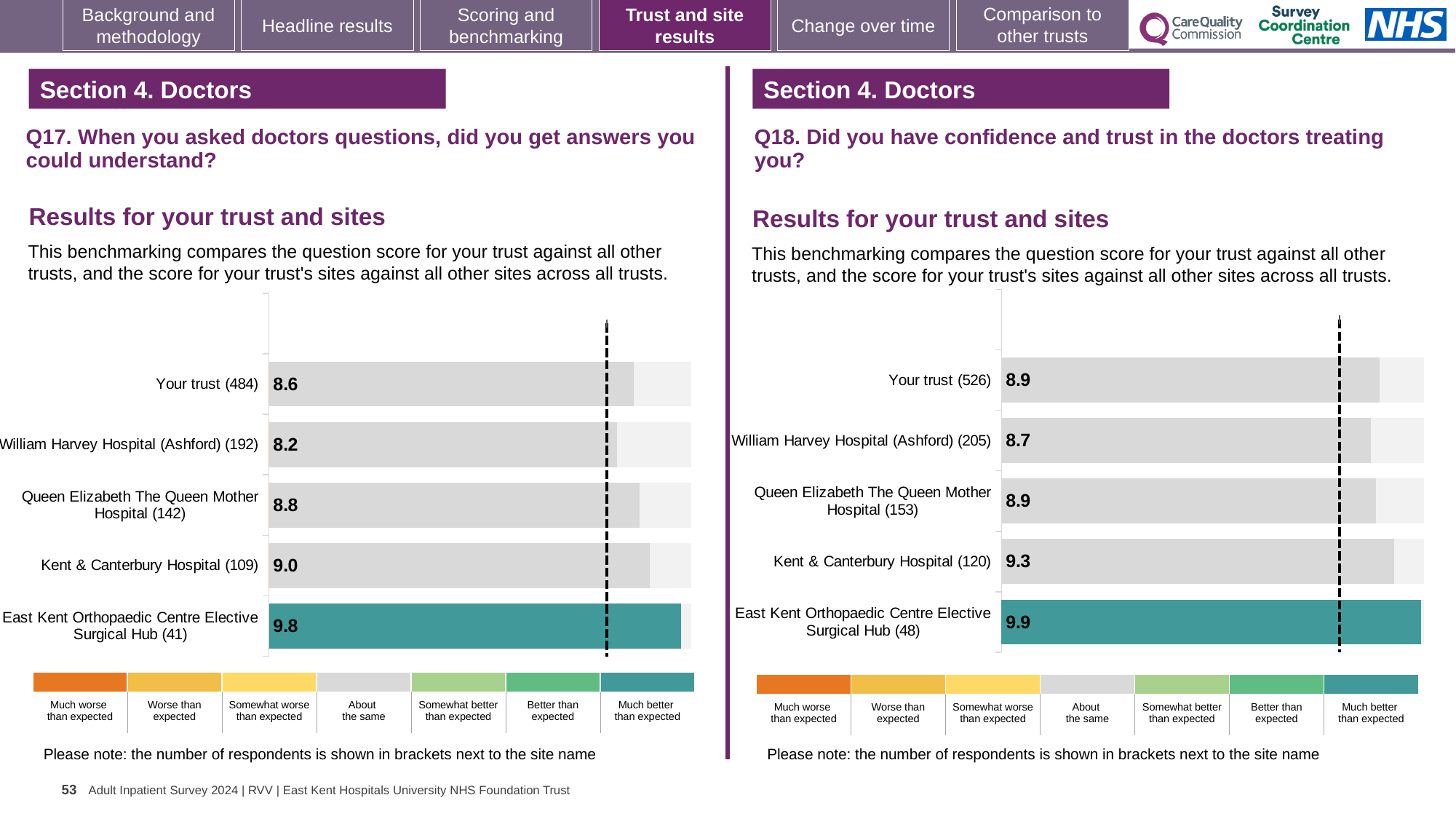
On the Q18 chart (right), what is the score for Kent & Canterbury Hospital (120)? 9.3 On the Q18 chart (right), which site has the highest score? East Kent Orthopaedic Centre Elective Surgical Hub (48) What type of chart is used on the Q18 chart (right)? Bar chart On the Q18 chart (right), what is the difference between the scores for East Kent Orthopaedic Centre Elective Surgical Hub (48) and Your trust (526)? 1.0 On the Q17 chart (left), what is the score for Your trust (484)? 8.6 On the Q17 chart (left), what is the difference between the scores for East Kent Orthopaedic Centre Elective Surgical Hub (41) and William Harvey Hospital (Ashford) (192)? 1.6 On the Q17 chart (left), which site has the highest score? East Kent Orthopaedic Centre Elective Surgical Hub (41) On the Q17 chart (left), what is the score for Kent & Canterbury Hospital (109)? 9.0 On the Q18 chart (right), which is larger: the score for Kent & Canterbury Hospital (120) or the score for Your trust (526)? Kent & Canterbury Hospital (120) On the Q17 chart (left), which site has the lowest score? William Harvey Hospital (Ashford) (192) On the Q17 chart (left), how many bars are plotted? 5 On the Q18 chart (right), what is the score for William Harvey Hospital (Ashford) (205)? 8.7